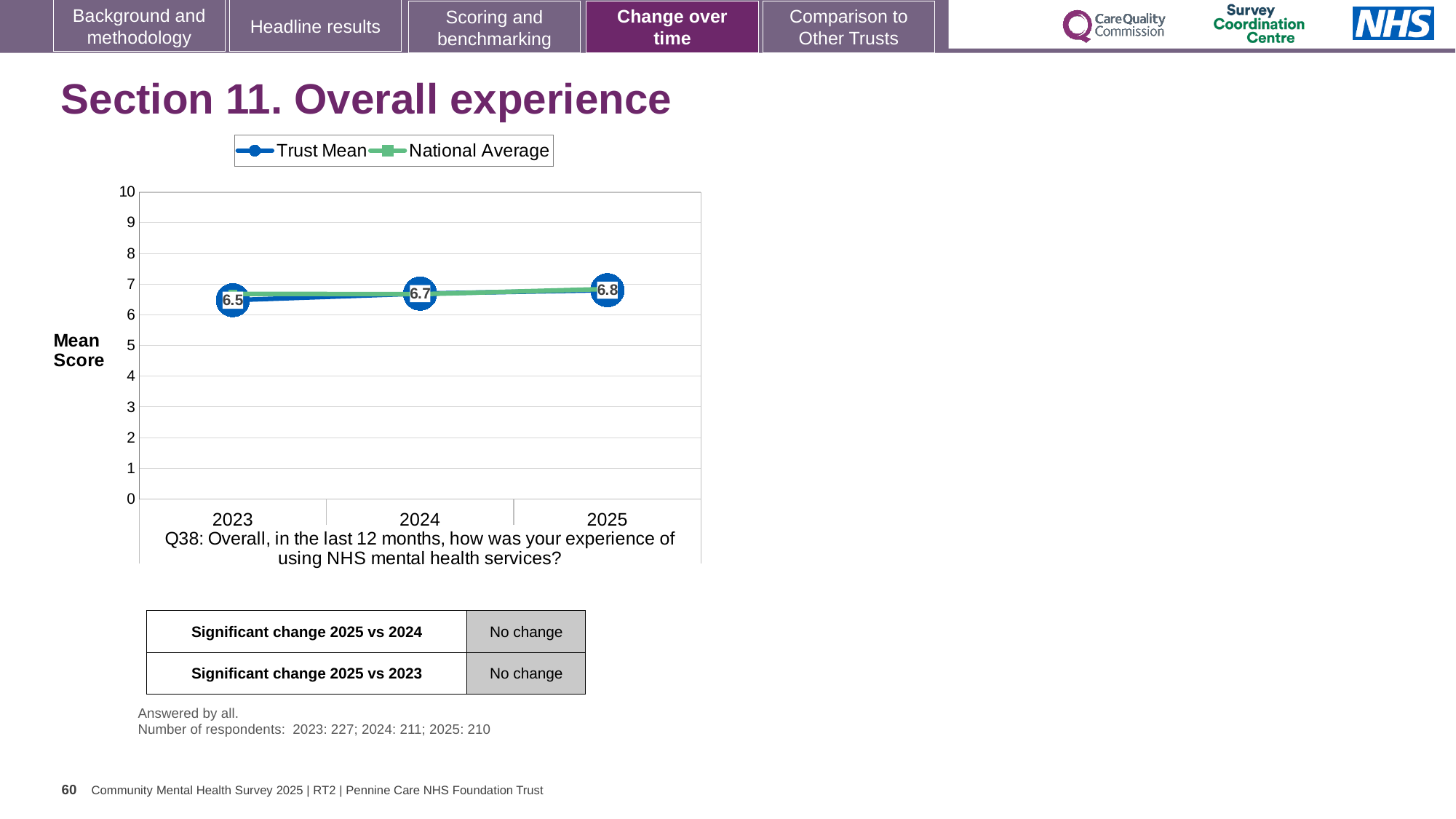
What kind of chart is shown on the slide? line chart What are the two series named in the legend? Trust Mean and National Average Is the National Average value for 2025 greater or less than 5? greater What is the Trust Mean score for 2023? 6.5 How many years are plotted on the x axis? 3 In which year is the Trust Mean score lowest? 2023 In which year is the Trust Mean score highest? 2025 Does the Trust Mean score rise or fall from 2023 to 2025? rise How many series does the legend list? 2 What is the difference between the Trust Mean score in 2025 and in 2023? 0.3 What is the Trust Mean score for 2025? 6.8 What is the Trust Mean score for 2024? 6.7